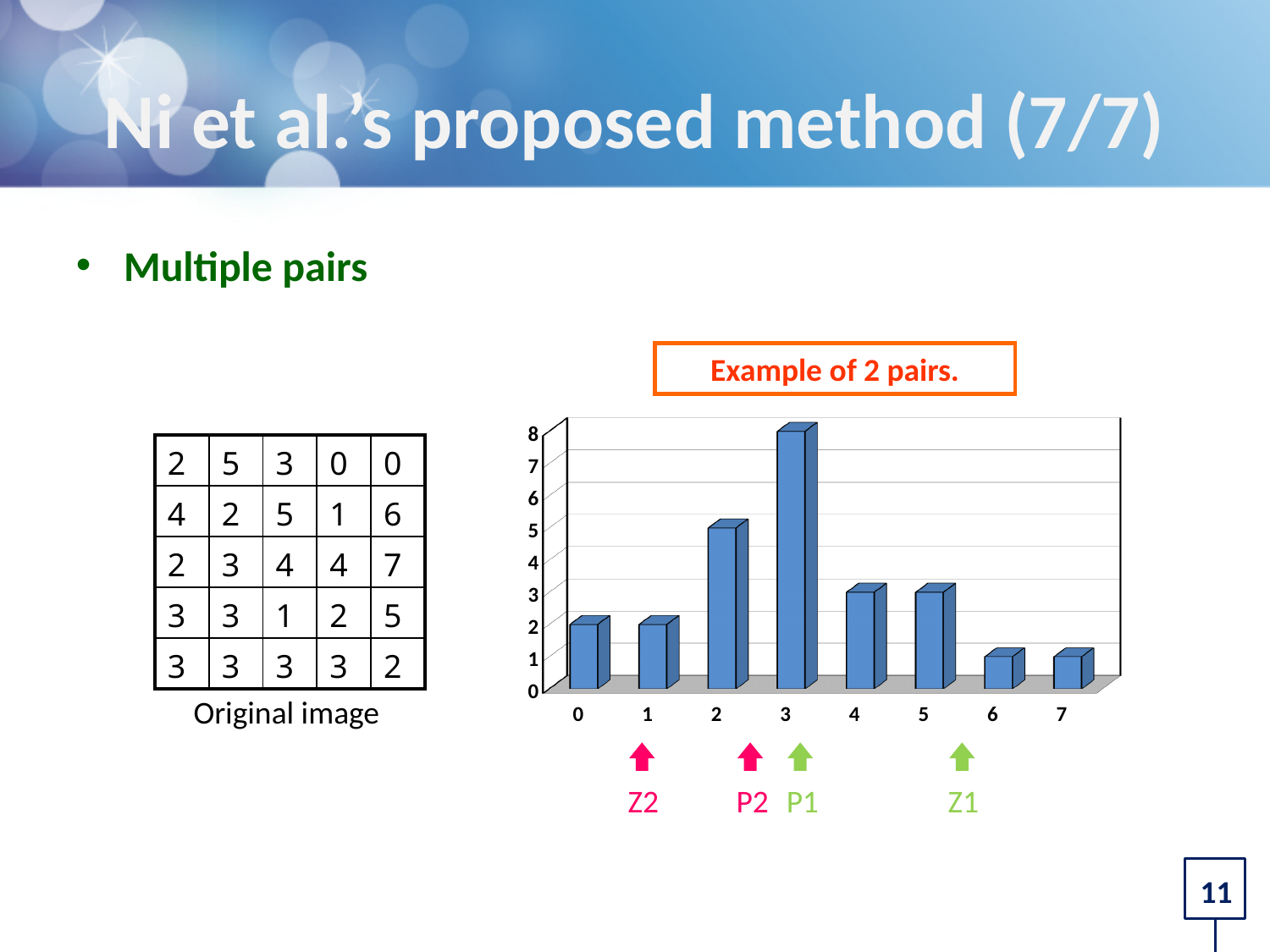
Is the value for category 6 greater or less than 2? less Is the value for category 3 greater or less than 7? greater Which is larger, the bar for category 5 or the bar for category 7? category 5 What kind of chart is shown on the slide? bar chart What text is shown in the orange box above the chart? Example of 2 pairs. Which is larger, the bar for category 2 or the bar for category 4? category 2 Is the value for category 2 greater or less than 4? greater What is the difference between the bar for category 3 and the bar for category 2? 3 How many categories are shown on the x axis of the chart? 8 What is the value of the bar for category 3? 8 What is the value of the bar for category 2? 5 Which category has the highest bar in the chart? 3